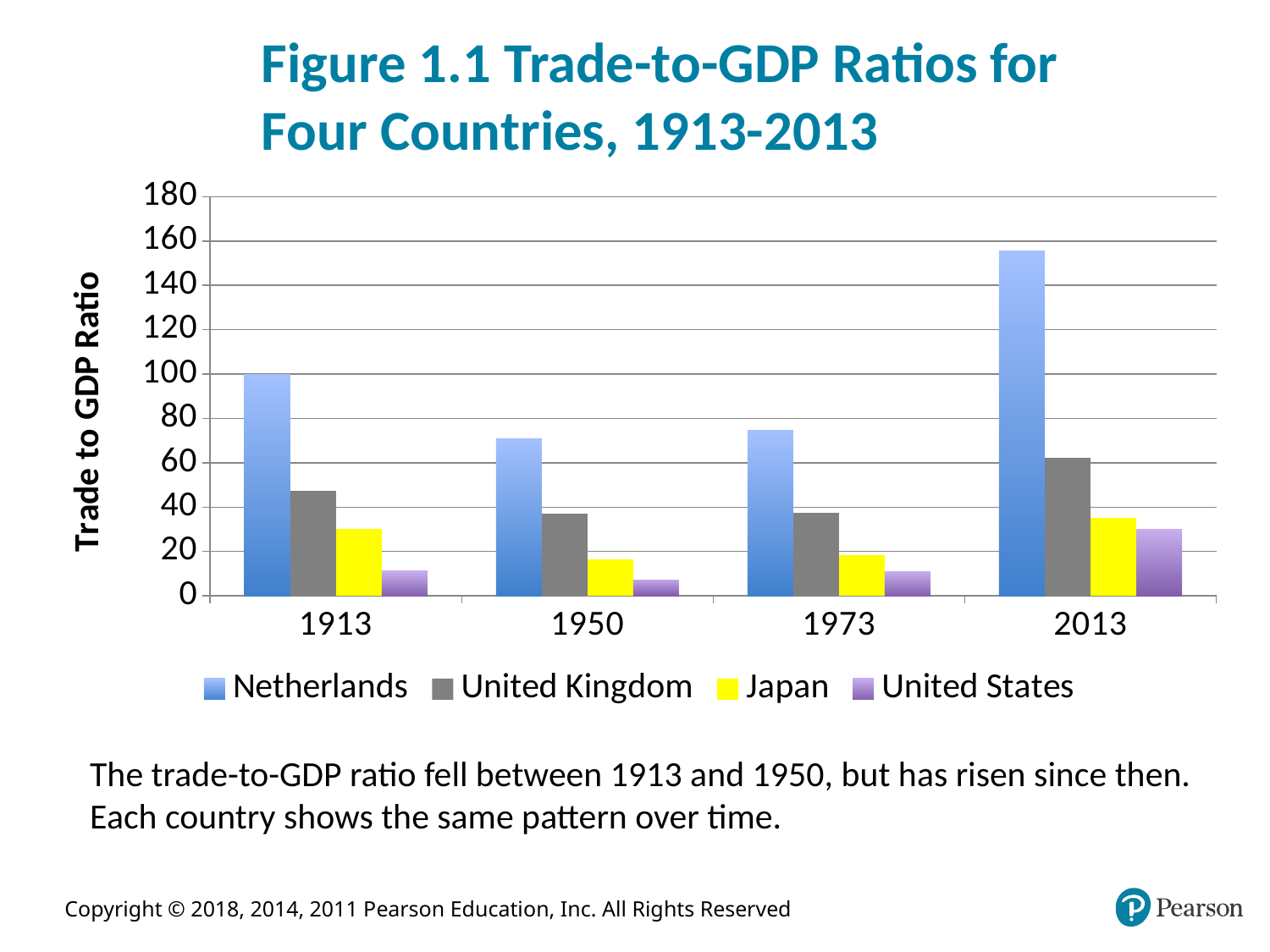
Is the value for the United Kingdom in 1913 greater or less than 40? greater Which country has the lowest trade-to-GDP ratio in 1950? United States Is the value for the Netherlands in 1950 greater or less than 80? less Is the value for the Netherlands in 2013 greater or less than 140? greater Which country has the highest trade-to-GDP ratio in 2013? Netherlands Does the Netherlands' trade-to-GDP ratio rise or fall between 1973 and 2013? rise How many series does the legend list? 4 What kind of chart is shown on the slide? bar chart What is the title of the vertical axis? Trade to GDP Ratio In 1973, which is larger: the value for the Netherlands or the value for the United Kingdom? Netherlands How many years are shown on the x axis? 4